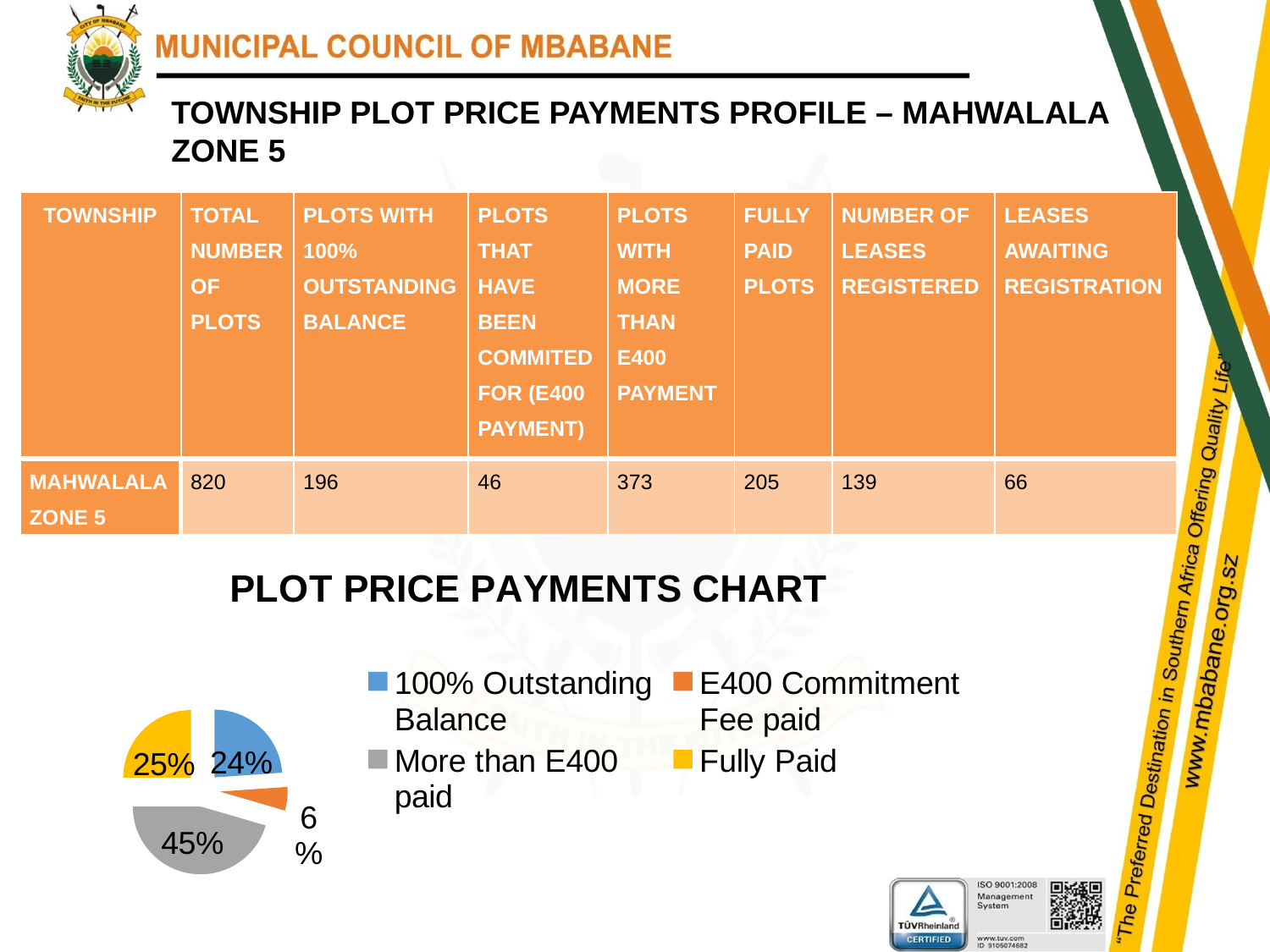
What share of the pie chart is labelled 'E400 Commitment Fee paid'? 6% What share of the pie chart is labelled 'More than E400 paid'? 45% Which category has the largest slice in the pie chart? More than E400 paid Which slice is larger: 'Fully Paid' or 'E400 Commitment Fee paid'? Fully Paid Which category has the smallest slice in the pie chart? E400 Commitment Fee paid What is the difference in percentage points between the 'More than E400 paid' slice and the 'Fully Paid' slice? 20 What colour is the 'More than E400 paid' slice in the pie chart? grey How many slices does the pie chart have? 4 What share of the pie chart is labelled '100% Outstanding Balance'? 24% What type of chart is shown under the heading 'PLOT PRICE PAYMENTS CHART'? pie chart What share of the pie chart is labelled 'Fully Paid'? 25% How many entries does the pie chart legend list? 4